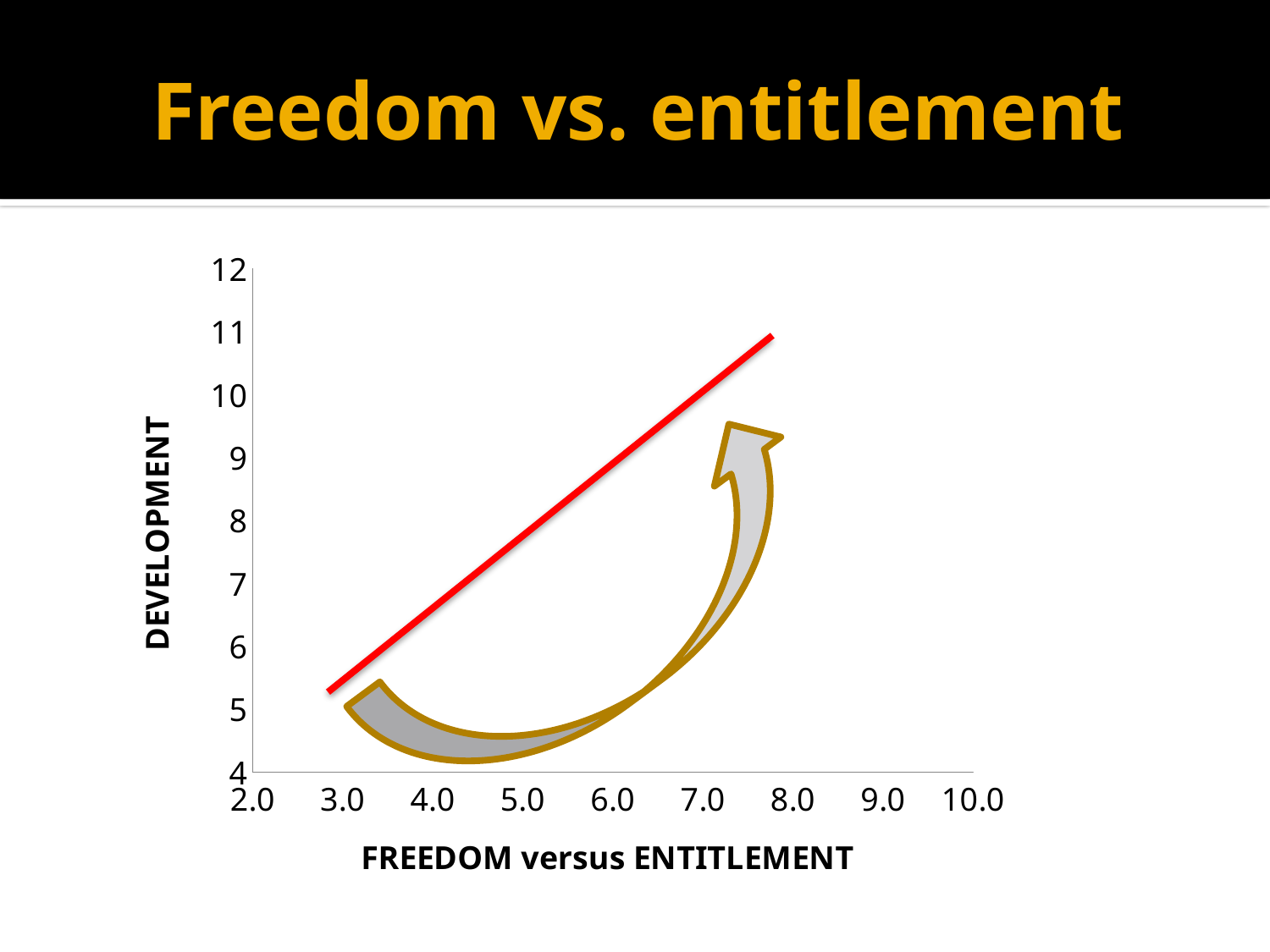
Does the red line rise or fall as the value on the x axis increases? rises How many tick labels are shown on the x axis? 9 What is the title of the x axis? FREEDOM versus ENTITLEMENT What kind of chart is shown on the slide? line chart Is the lowest point of the red line greater or less than 6 on the DEVELOPMENT axis? less How many lines are plotted on the chart? 1 At an x value of 3.0, is the red line's DEVELOPMENT value greater or less than 7? less At an x value of 4.0, is the red line's DEVELOPMENT value greater or less than 6? greater What is the title of the y axis? DEVELOPMENT